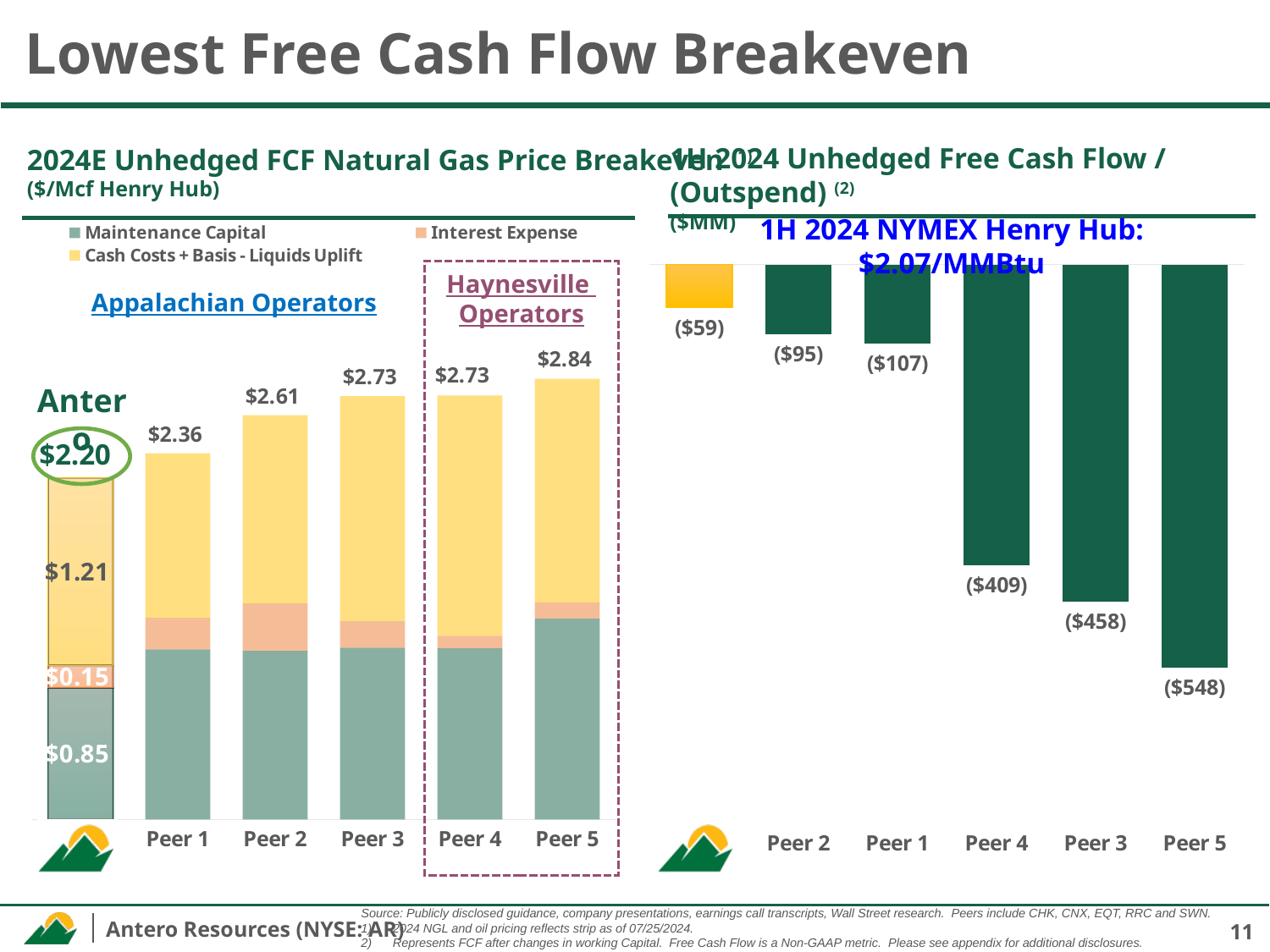
In the 1H 2024 Unhedged Free Cash Flow / (Outspend) chart, what is the value for Peer 3? ($458) In the 2024E Unhedged FCF Natural Gas Price Breakeven chart, do the breakeven values rise or fall from left to right? rise In the 2024E Unhedged FCF Natural Gas Price Breakeven chart, what is the breakeven value for Peer 5? $2.84 In the 2024E Unhedged FCF Natural Gas Price Breakeven chart, what is the breakeven value for Peer 1? $2.36 In the 1H 2024 Unhedged Free Cash Flow / (Outspend) chart, which peer has the largest outspend? Peer 5 In the 2024E Unhedged FCF Natural Gas Price Breakeven chart, what is the Maintenance Capital component of Antero's breakeven? $0.85 In the 2024E Unhedged FCF Natural Gas Price Breakeven chart, which operator has the highest breakeven? Peer 5 In the 2024E Unhedged FCF Natural Gas Price Breakeven chart, what is the difference between Peer 5's breakeven and Antero's breakeven? $0.64 In the 1H 2024 Unhedged Free Cash Flow / (Outspend) chart, how many bars are plotted? 6 In the 2024E Unhedged FCF Natural Gas Price Breakeven chart, how many series does the legend list? 3 What kind of chart is the 1H 2024 Unhedged Free Cash Flow / (Outspend) chart? bar chart In the 2024E Unhedged FCF Natural Gas Price Breakeven chart, which operator has the lowest breakeven? Antero